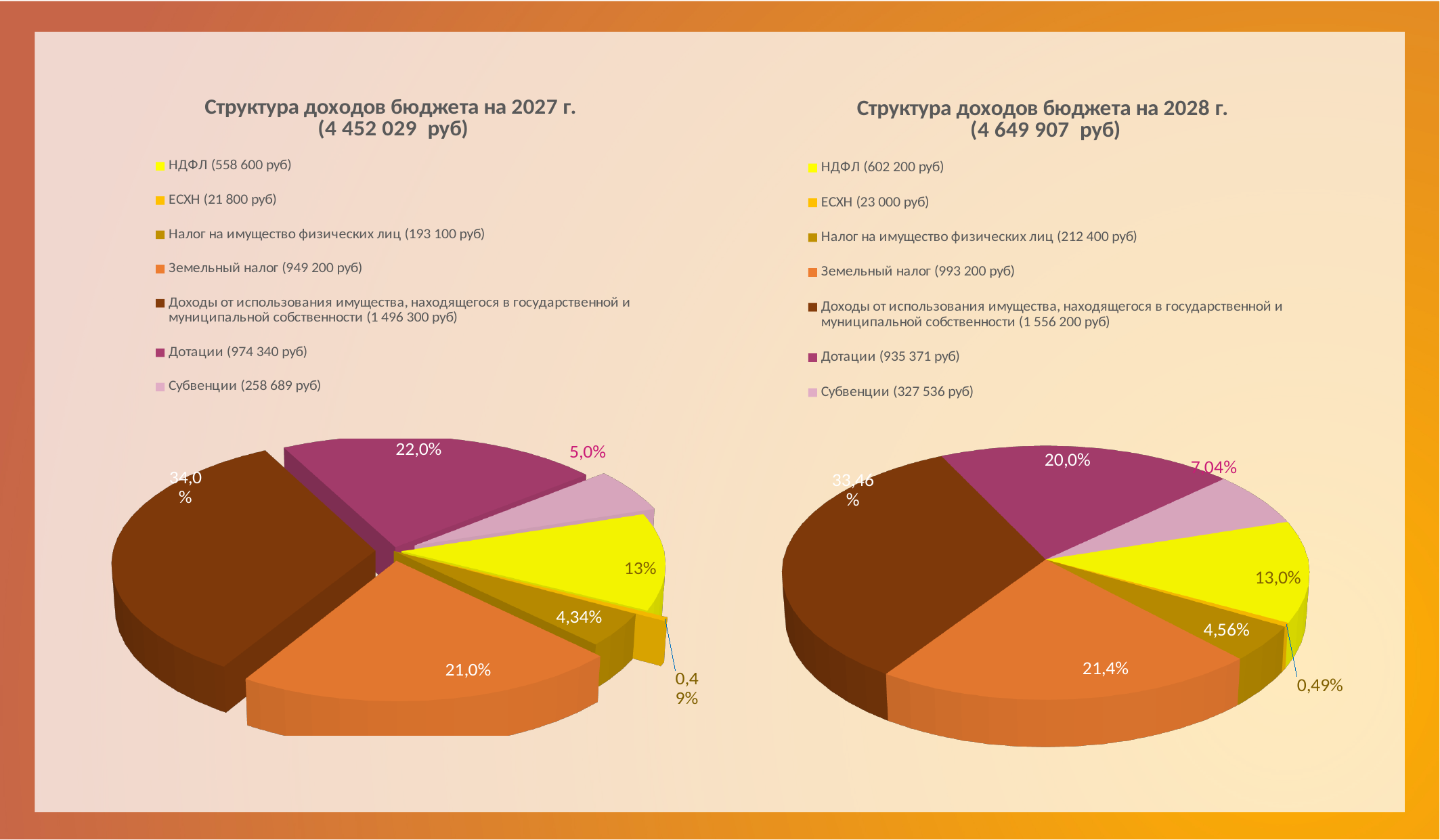
What kind of chart is shown on the left side of the slide (Структура доходов бюджета на 2027 г.)? pie chart In the chart 'Структура доходов бюджета на 2028 г.', what percentage is shown for the Налог на имущество физических лиц slice? 4,56% In the chart 'Структура доходов бюджета на 2028 г.', which slice is larger: Дотации or Земельный налог? Земельный налог How many slices does the chart 'Структура доходов бюджета на 2028 г.' have? 7 In the chart 'Структура доходов бюджета на 2028 г.', which category has the smallest slice? ЕСХН What total amount in rubles is shown in the title of the left chart for 2027? 4 452 029 руб In the chart 'Структура доходов бюджета на 2027 г.', what percentage is shown for the Дотации slice? 22,0% In the chart 'Структура доходов бюджета на 2028 г.', what percentage is shown for the Субвенции slice? 7,04% In the chart 'Структура доходов бюджета на 2027 г.', which category has the largest slice? Доходы от использования имущества, находящегося в государственной и муниципальной собственности In the chart 'Структура доходов бюджета на 2027 г.', what is the difference in percentage points between the Дотации slice (22,0%) and the НДФЛ slice (13%)? 9 percentage points According to the legend of the chart 'Структура доходов бюджета на 2028 г.', what is the amount in rubles for Дотации? 935 371 руб In the chart 'Структура доходов бюджета на 2027 г.', what percentage is shown for the Земельный налог slice? 21,0%